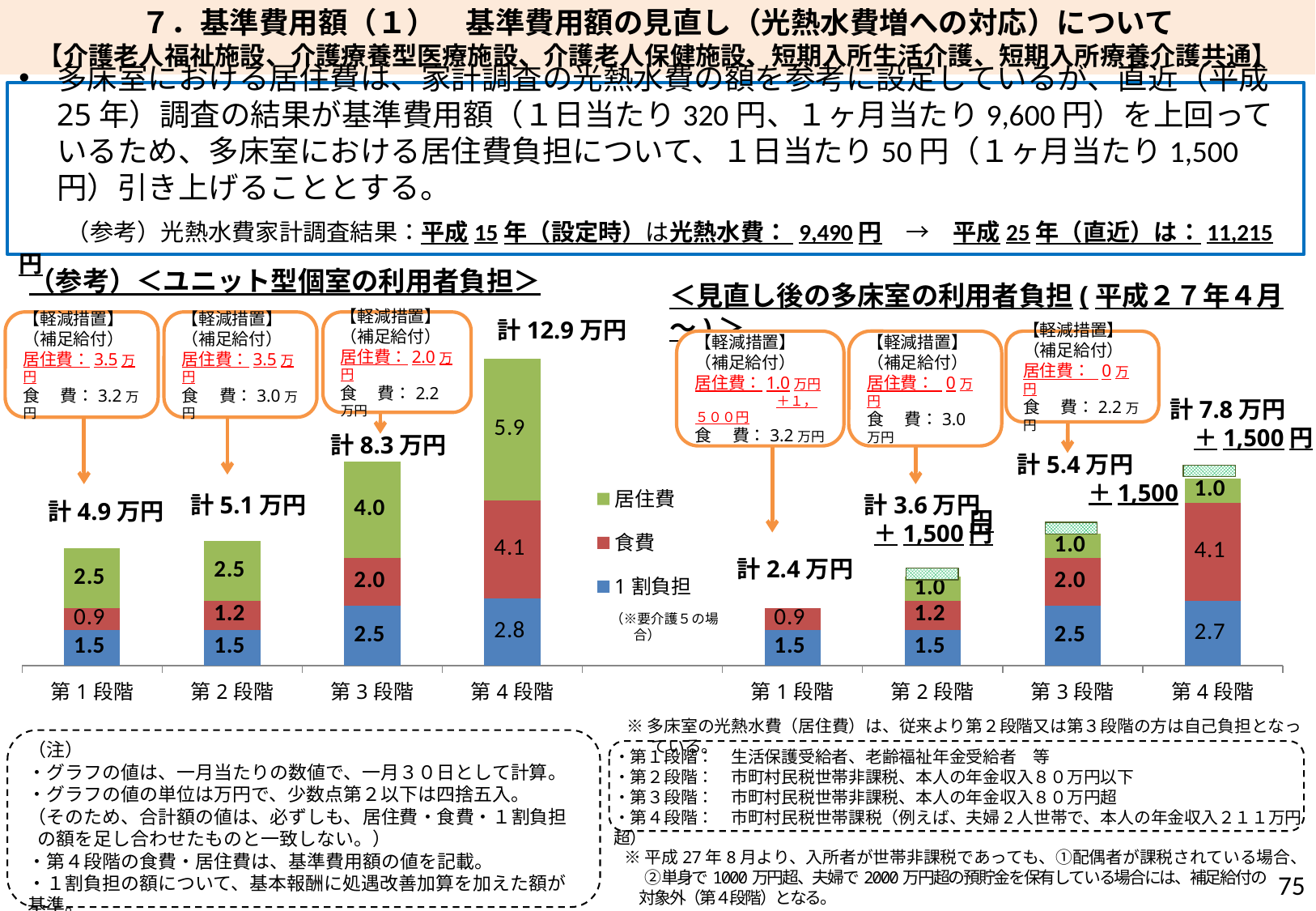
In the right chart (見直し後の多床室の利用者負担), which category has the lowest total? 第１段階 In the right chart (見直し後の多床室の利用者負担), what is the 食費 value for 第１段階? 0.9 What kind of chart is the right chart (見直し後の多床室の利用者負担)? Stacked bar chart In the right chart (見直し後の多床室の利用者負担), what is the printed total (計) for 第１段階? 計 2.4 万円 In the right chart (見直し後の多床室の利用者負担), what is the １割負担 value for 第４段階? 2.7 In the left chart (ユニット型個室の利用者負担), what is the difference between the 食費 values for 第４段階 and 第３段階? 2.1 In the left chart (ユニット型個室の利用者負担), what is the 食費 value for 第３段階? 2.0 How many series does the legend list for the charts? 3 In the left chart (ユニット型個室の利用者負担), which is larger: the 居住費 value for 第３段階 or the 居住費 value for 第２段階? 第３段階 In the left chart (ユニット型個室の利用者負担), which category has the highest total? 第４段階 In the left chart (ユニット型個室の利用者負担), what is the printed total (計) for 第４段階? 計 12.9 万円 In the left chart (ユニット型個室の利用者負担), what is the 居住費 value for 第４段階? 5.9